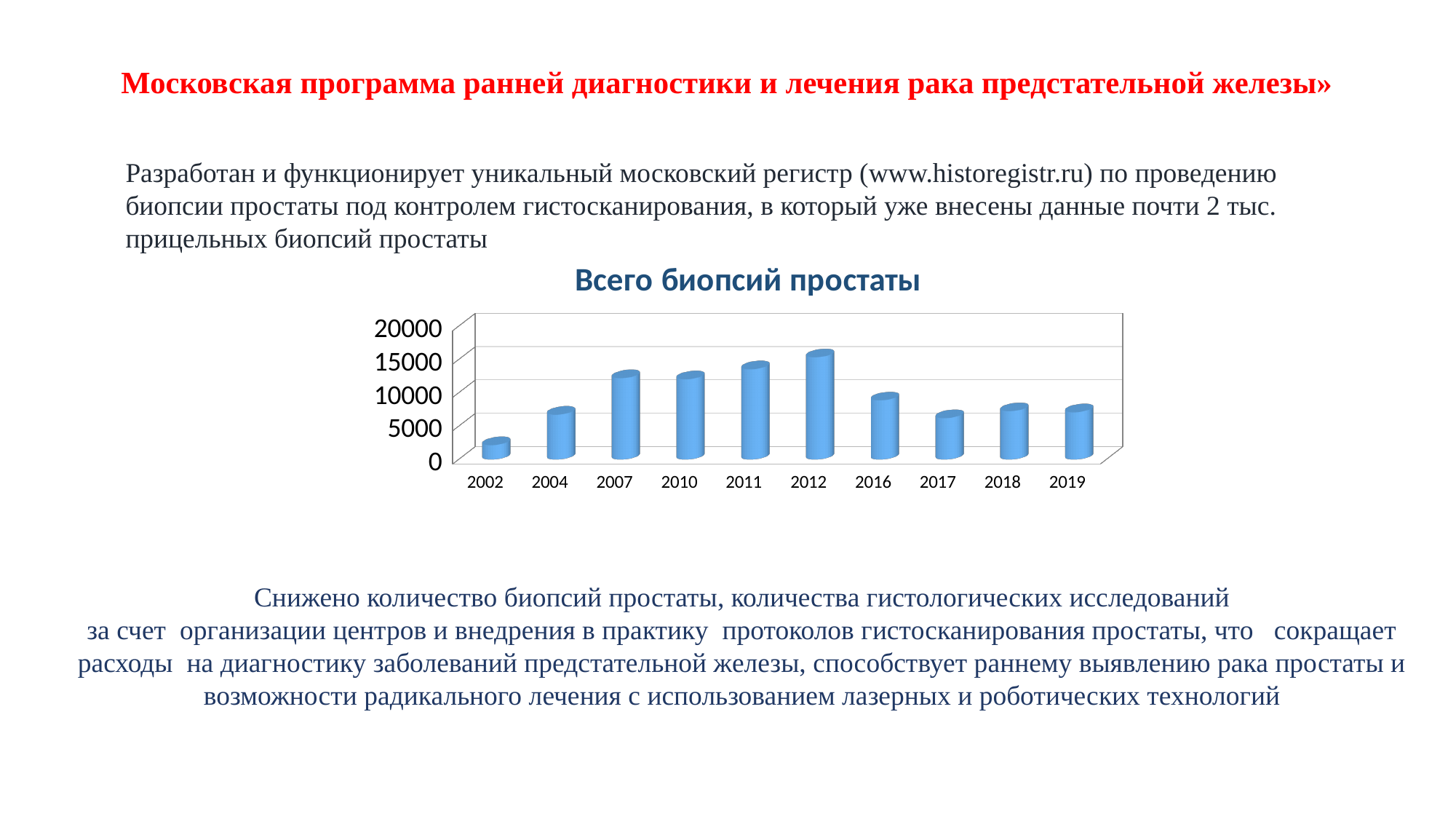
What kind of chart is shown on the slide? bar chart What is the title of the chart? Всего биопсий простаты Do the values rise or fall from 2012 to 2017? fall Which year has the highest value in the chart? 2012 Which is larger, the value for 2004 or the value for 2007? 2007 Is the value for 2002 greater or less than 5000? less Is the value for 2007 greater or less than 10000? greater Which is larger, the value for 2011 or the value for 2016? 2011 Is the value for 2012 greater or less than 10000? greater How many years are shown on the x axis of the chart? 10 Which year has the lowest value in the chart? 2002